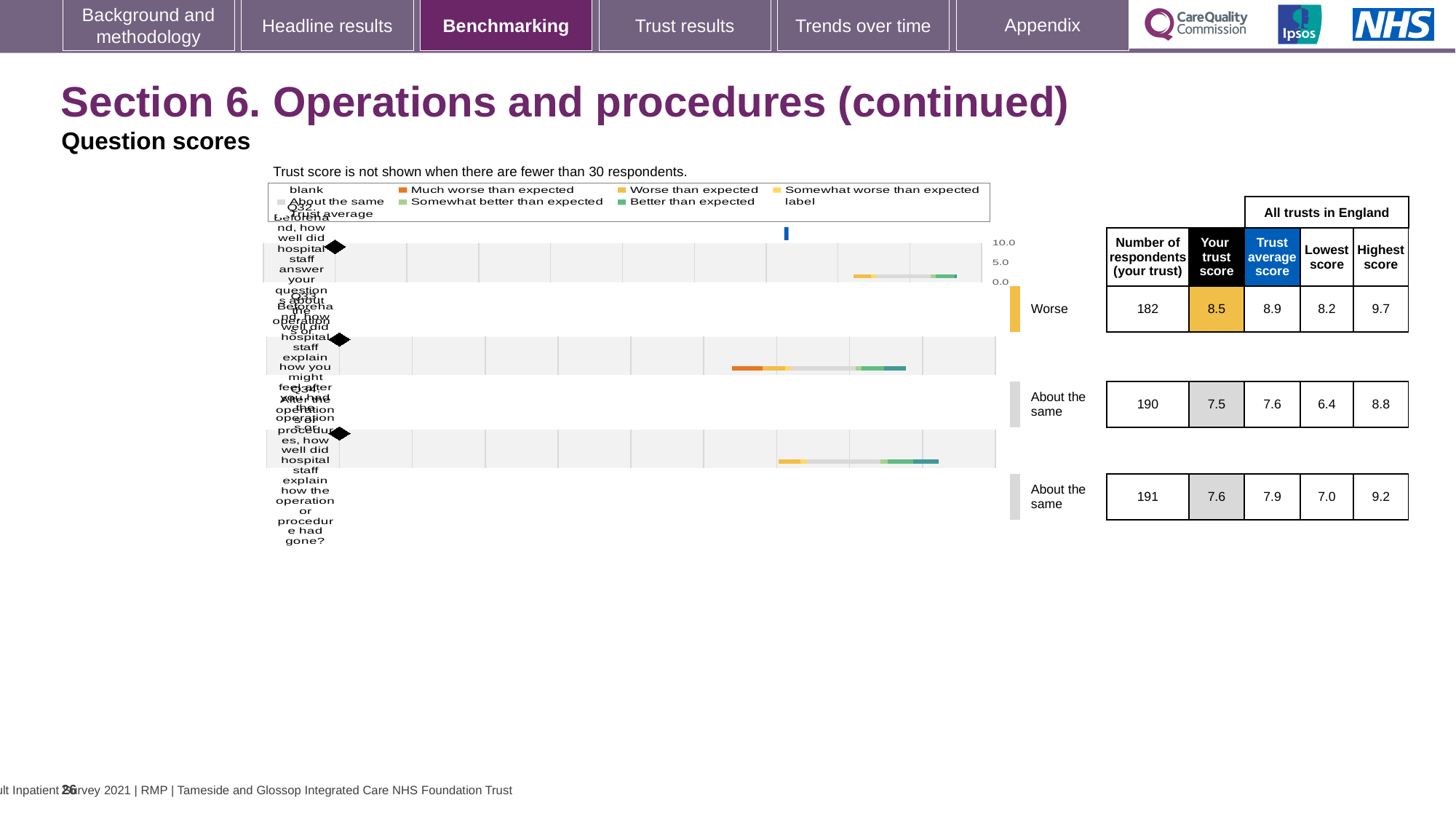
What is 'Your trust score' for the first question row (labelled 'Worse')? 8.5 What benchmark category label is shown next to the first question row? Worse In the third row (191 respondents), which is larger: 'Your trust score' or the trust average score? Trust average score What is the trust average score for the first question row (labelled 'Worse')? 8.9 How many question rows are plotted in the chart? 3 Which row has the highest 'Your trust score'? the first row (Worse), 8.5 What kind of chart is used to show the question scores on this slide? bar chart What is the difference between the trust average score and 'Your trust score' in the first row (Worse)? 0.4 What is the lowest score for the third question row (191 respondents)? 7.0 What is the number of respondents for the first question row (labelled 'Worse')? 182 What is the highest score for the row with 190 respondents? 8.8